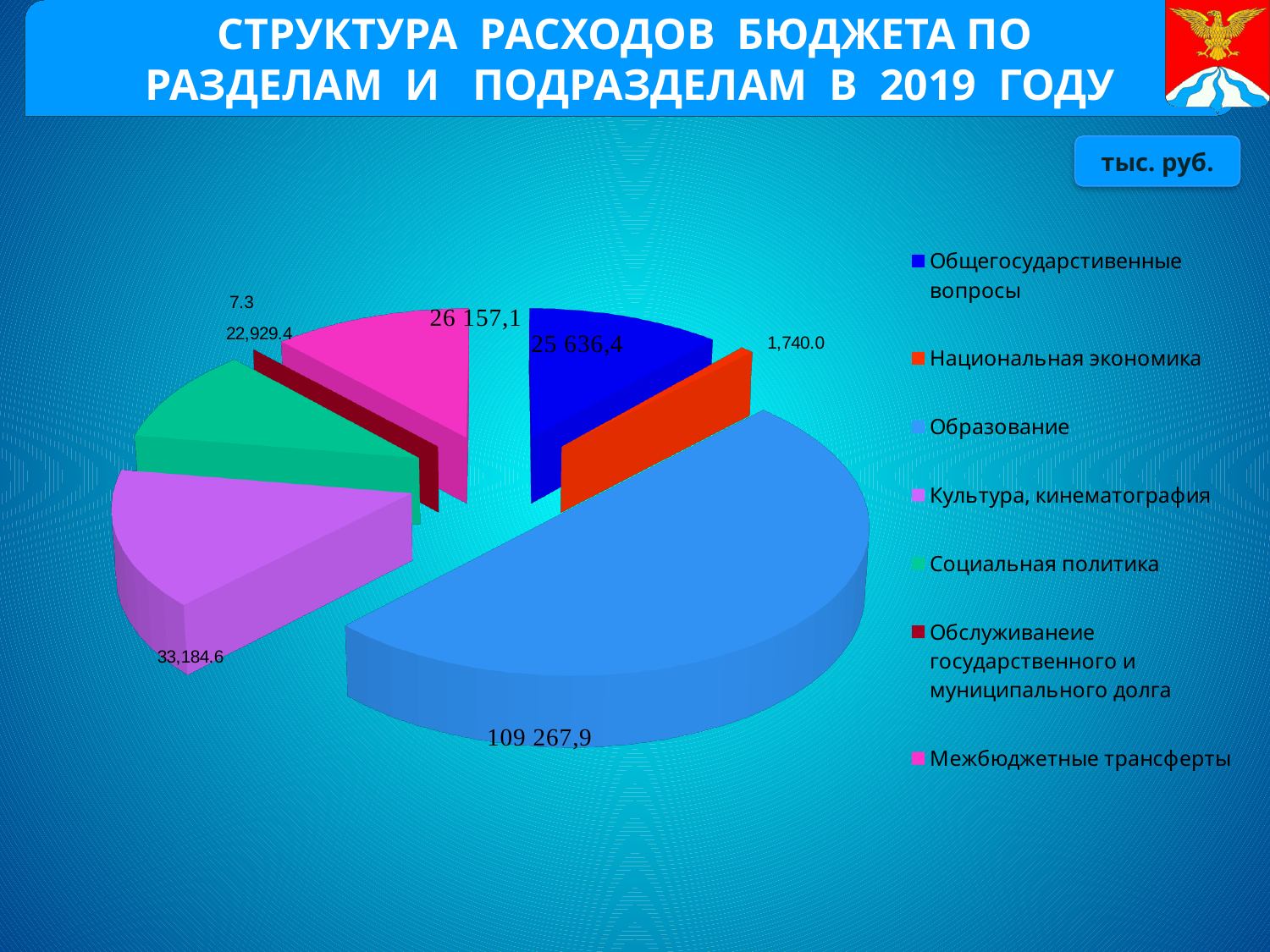
What is the value for Национальная экономика? 1,740.0 What is the value for Обслуживание государственного и муниципального долга? 7.3 What unit is indicated in the box at the top right of the slide? тыс. руб. Which category has the largest slice of the pie? Образование What is the value for Культура, кинематография? 33,184.6 What kind of chart is shown on the slide? pie chart What is the value for Межбюджетные трансферты? 26 157,1 Which is larger, Культура, кинематография or Социальная политика? Культура, кинематография What is the value for Образование? 109 267,9 How many categories does the legend list? 7 Which category has the smallest slice of the pie? Обслуживание государственного и муниципального долга What is the difference between Культура, кинематография and Социальная политика? 10,255.2